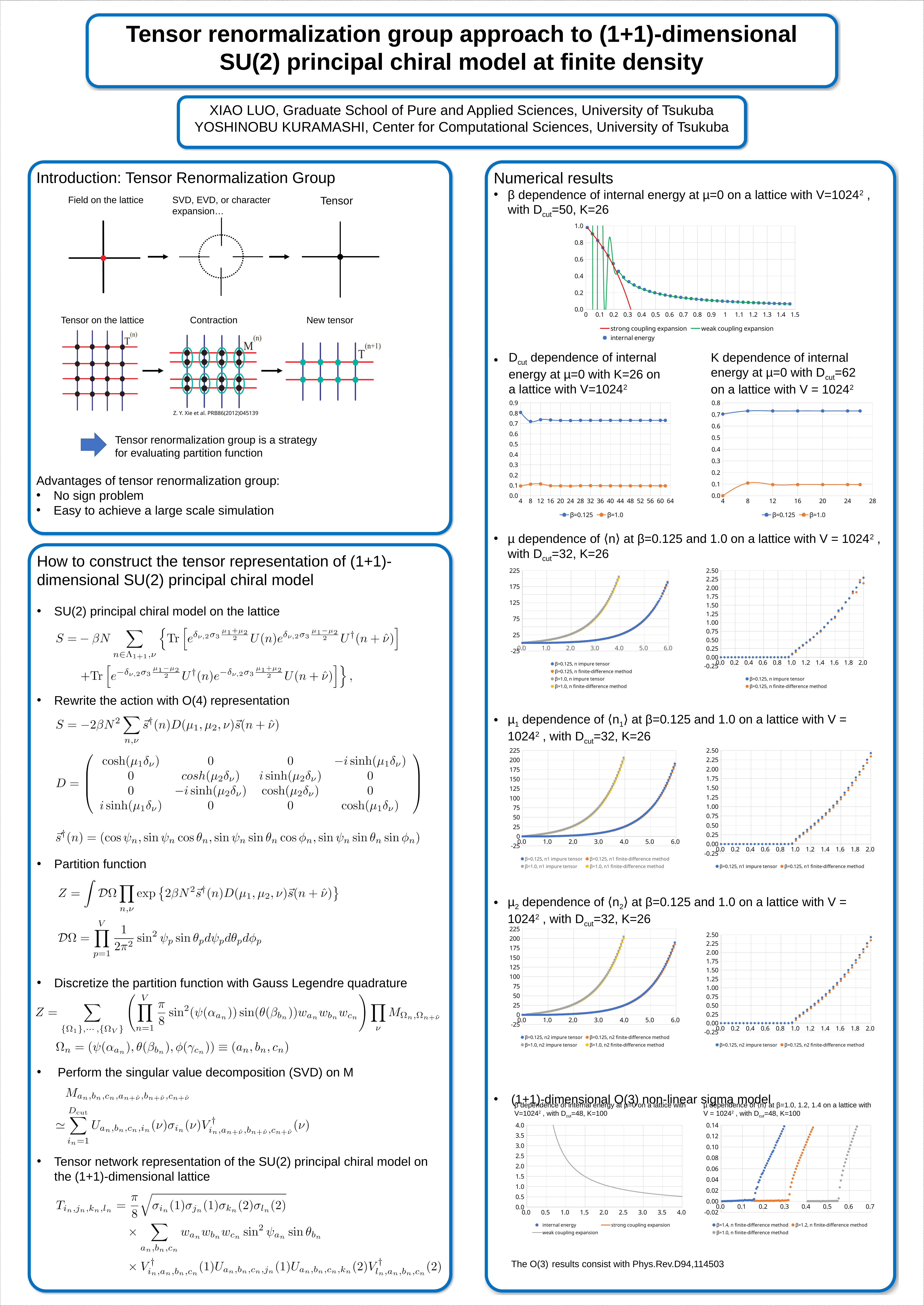
In the chart of K dependence of internal energy at μ=0 with D_cut=62, is the value for β=0.125 at K=26 greater or less than 0.5? greater In the chart of D_cut dependence of internal energy at μ=0 with K=26, is the value for β=1.0 at D_cut=64 greater or less than 0.5? less In the chart of D_cut dependence of internal energy at μ=0 with K=26, which series has the higher values, β=0.125 or β=1.0? β=0.125 In the chart of D_cut dependence of internal energy at μ=0 with K=26, how many series does the legend list? 2 In the chart of K dependence of internal energy at μ=0 with D_cut=62, what are the two legend entries? β=0.125 and β=1.0 In the right chart of μ dependence of ⟨n⟩ at β=0.125, does ⟨n⟩ rise or fall as μ increases from 1.0 to 2.0? rise In the chart of β dependence of internal energy at μ=0, does the internal energy rise or fall as β increases? fall What kind of chart is the D_cut dependence of internal energy at μ=0 with K=26? line chart In the chart of β dependence of internal energy at μ=0, is the internal energy at β=1.5 greater or less than 0.2? less In the chart of β dependence of internal energy at μ=0 (top of the Numerical results panel), how many series does the legend list? 3 In the left chart of μ dependence of ⟨n⟩ at β=0.125 and 1.0, how many series does the legend list? 4